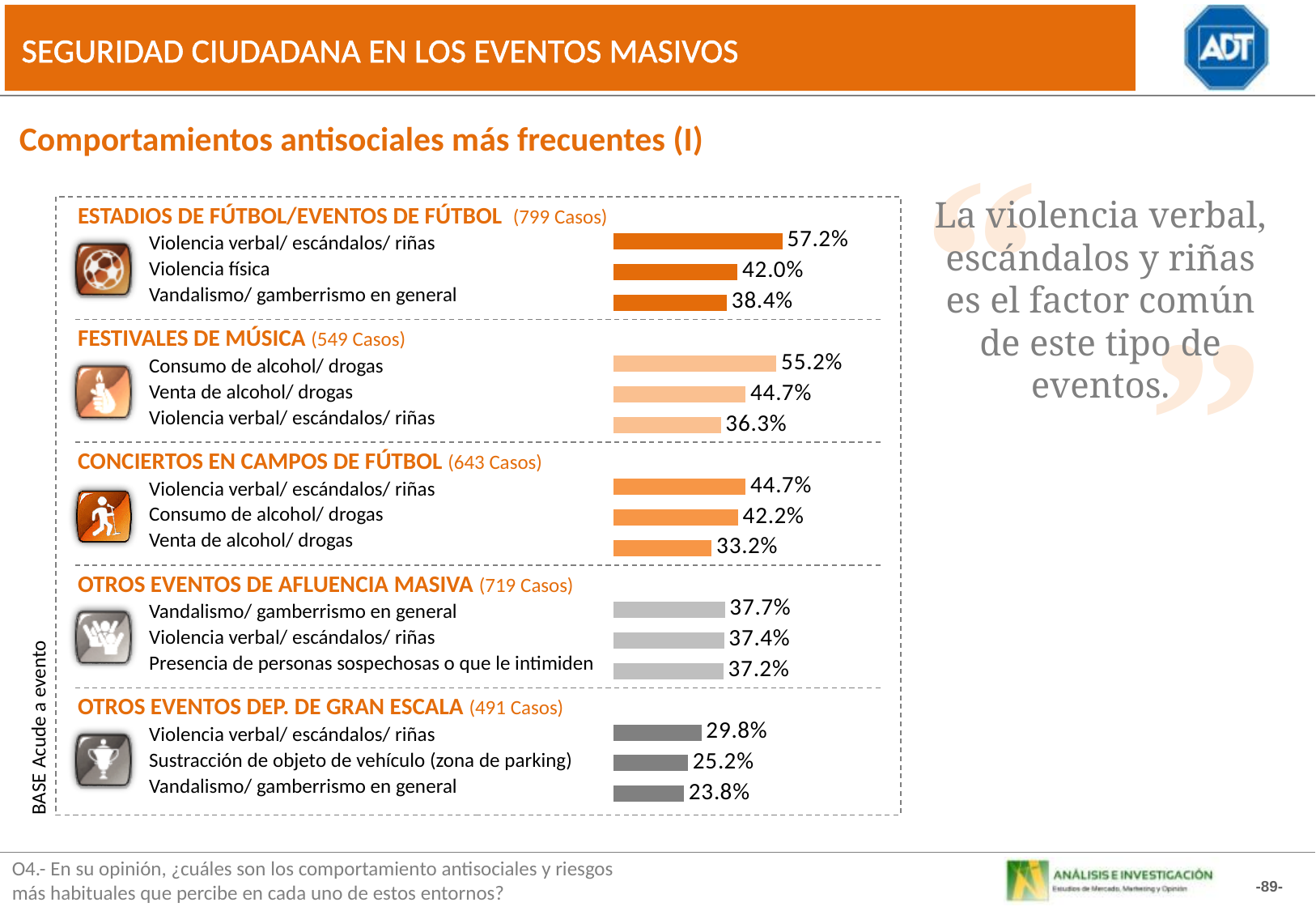
In the ESTADIOS DE FÚTBOL/EVENTOS DE FÚTBOL chart, what is the value for Violencia verbal/ escándalos/ riñas? 57.2% In the CONCIERTOS EN CAMPOS DE FÚTBOL chart, which is larger: Violencia verbal/ escándalos/ riñas or Consumo de alcohol/ drogas? Violencia verbal/ escándalos/ riñas In the OTROS EVENTOS DEP. DE GRAN ESCALA chart, what is the value for Sustracción de objeto de vehículo (zona de parking)? 25.2% In the ESTADIOS DE FÚTBOL/EVENTOS DE FÚTBOL chart, what is the difference between Violencia verbal/ escándalos/ riñas and Violencia física? 15.2% In the ESTADIOS DE FÚTBOL/EVENTOS DE FÚTBOL chart, which category has the lowest value? Vandalismo/ gamberrismo en general In the CONCIERTOS EN CAMPOS DE FÚTBOL chart, what is the value for Venta de alcohol/ drogas? 33.2% How many categories are shown in the OTROS EVENTOS DEP. DE GRAN ESCALA chart? 3 In the FESTIVALES DE MÚSICA chart, what is the difference between Consumo de alcohol/ drogas and Violencia verbal/ escándalos/ riñas? 18.9% In the OTROS EVENTOS DE AFLUENCIA MASIVA chart, which category has the highest value? Vandalismo/ gamberrismo en general How many cases (Casos) are indicated for the CONCIERTOS EN CAMPOS DE FÚTBOL chart? 643 Casos In the FESTIVALES DE MÚSICA chart, what is the value for Venta de alcohol/ drogas? 44.7% What kind of chart is used for the FESTIVALES DE MÚSICA data? Bar chart